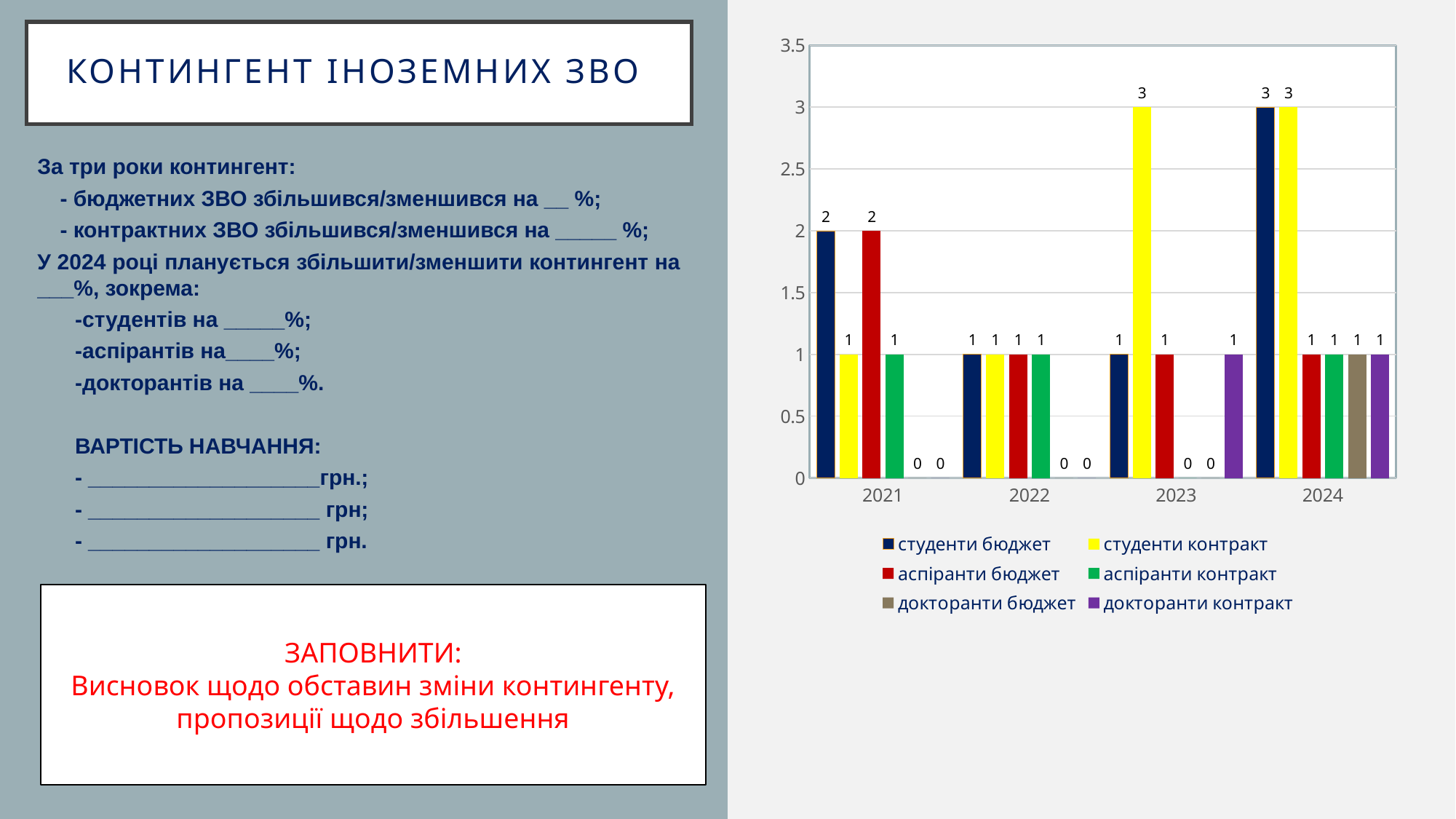
What is the value for докторанти бюджет in 2024? 1 What kind of chart is shown on the slide? bar chart Does the value for студенти контракт rise or fall from 2022 to 2023? rise What is the difference between студенти бюджет in 2024 and студенти бюджет in 2023? 2 Which colour represents докторанти контракт in the chart legend? purple What is the value for студенти контракт in 2023? 3 Which is larger in 2021: студенти бюджет or студенти контракт? студенти бюджет How many years are shown on the x axis of the chart? 4 What is the value for аспіранти бюджет in 2021? 2 How many series does the chart legend list? 6 In which year is the value for студенти бюджет highest? 2024 What is the value for аспіранти контракт in 2023? 0